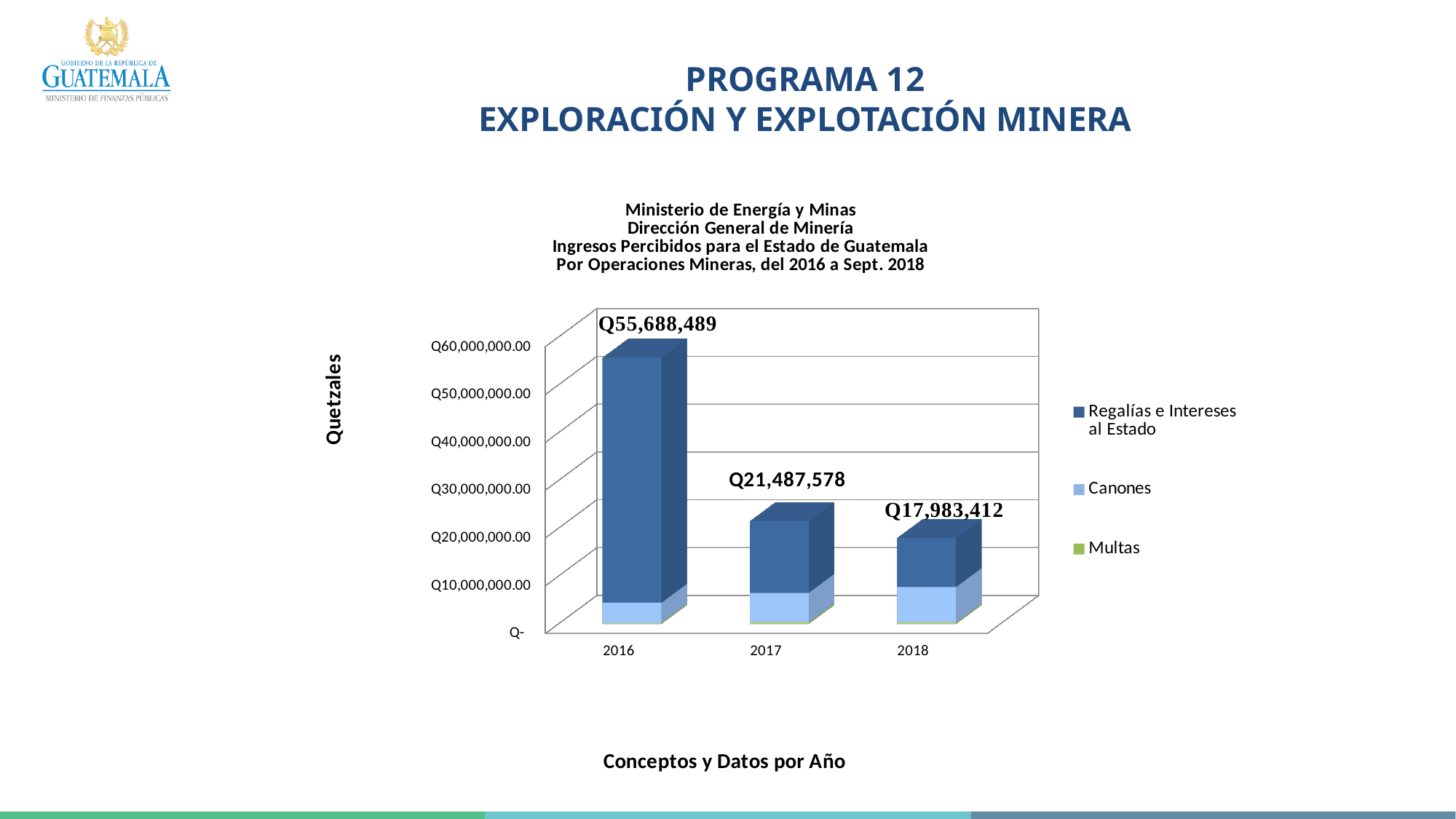
How many years are shown on the x axis? 3 Which year has the highest total income shown? 2016 What is the difference between the 2017 total and the 2018 total? Q3,504,166 What is the total labelled on the bar for 2016? Q55,688,489 What is the difference between the 2016 total and the 2017 total? Q34,200,911 How many series does the legend list? 3 What is the total labelled on the bar for 2017? Q21,487,578 Do the total values rise or fall from 2016 to 2018? fall Which is larger, the total for 2017 or the total for 2018? 2017 Is the Canones segment for 2016 greater or less than Q10,000,000.00? less Which year has the lowest total income shown? 2018 What is the total labelled on the bar for 2018? Q17,983,412